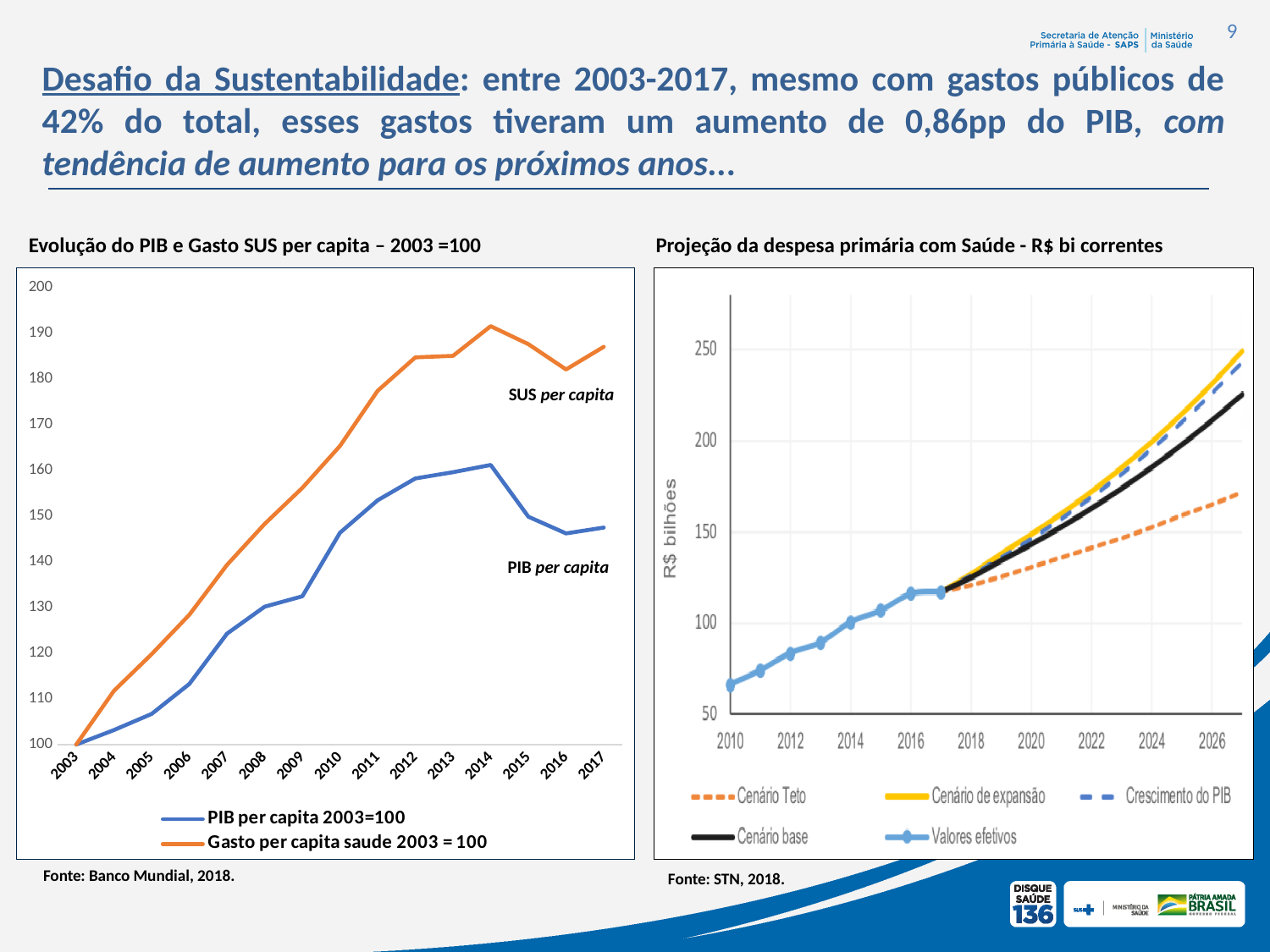
How many series does the legend of the right chart 'Projeção da despesa primária com Saúde' list? 5 In the left chart 'Evolução do PIB e Gasto SUS per capita', is the value of 'Gasto per capita saude 2003 = 100' in 2014 greater or less than 180? greater What is the y-axis label of the right chart 'Projeção da despesa primária com Saúde'? R$ bilhões In the left chart 'Evolução do PIB e Gasto SUS per capita', in which year does the 'Gasto per capita saude 2003 = 100' series reach its highest value? 2014 What kind of chart is the left chart, 'Evolução do PIB e Gasto SUS per capita – 2003 =100'? Line chart In the right chart 'Projeção da despesa primária com Saúde', which scenario is highest in 2027: 'Cenário Teto' or 'Cenário de expansão'? Cenário de expansão In the left chart 'Evolução do PIB e Gasto SUS per capita', is the value of 'PIB per capita 2003=100' in 2017 greater or less than 150? less How many series does the legend of the left chart 'Evolução do PIB e Gasto SUS per capita' list? 2 In the left chart 'Evolução do PIB e Gasto SUS per capita', does the 'PIB per capita 2003=100' series rise or fall between 2014 and 2016? Fall In the left chart 'Evolução do PIB e Gasto SUS per capita', which series is higher in 2017: 'PIB per capita 2003=100' or 'Gasto per capita saude 2003 = 100'? Gasto per capita saude 2003 = 100 In the right chart 'Projeção da despesa primária com Saúde', is the value of 'Cenário Teto' in 2027 greater or less than 200? less How many years are plotted on the x axis of the left chart 'Evolução do PIB e Gasto SUS per capita'? 15